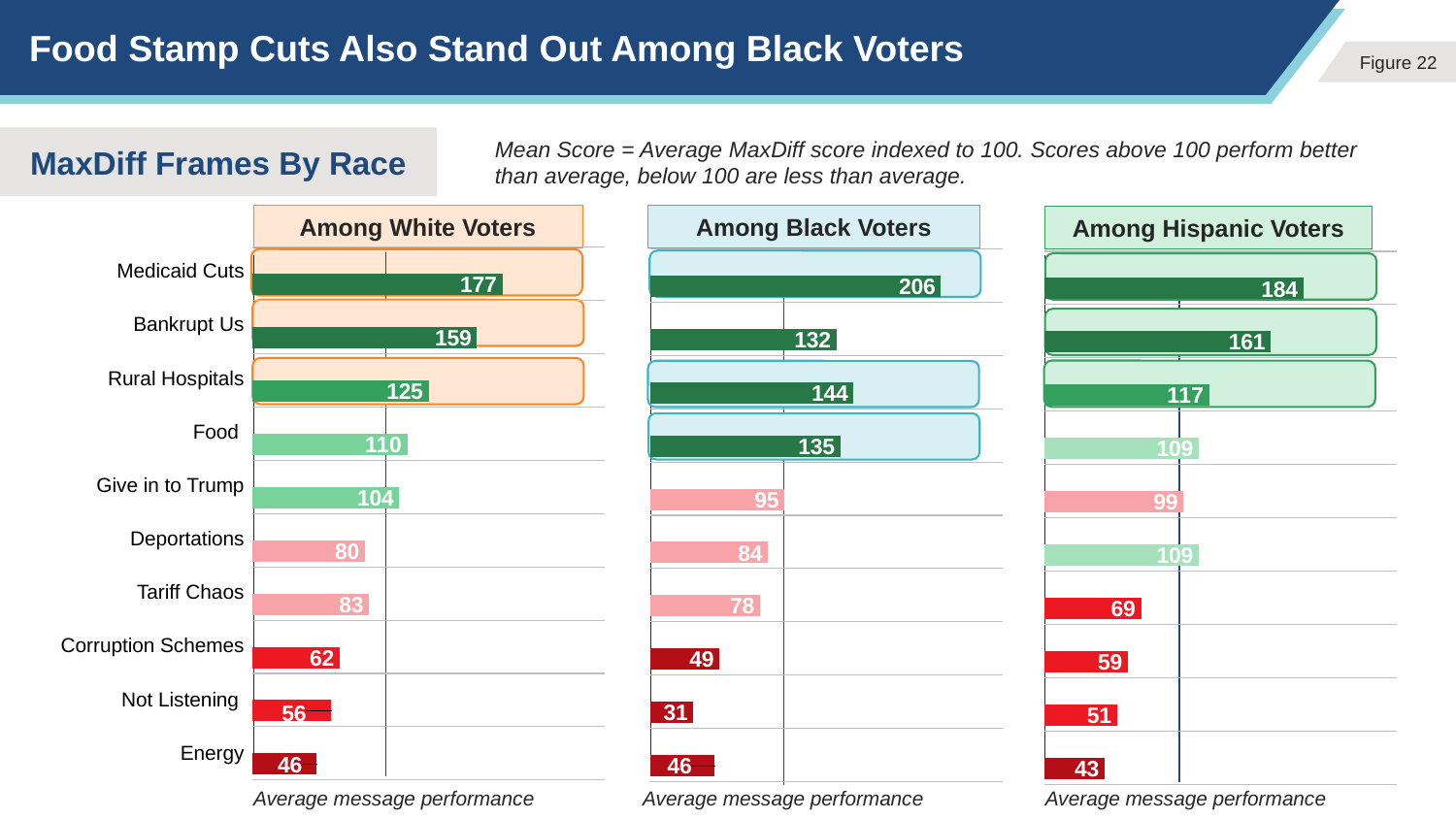
In the Among Hispanic Voters chart, what is the value for Rural Hospitals? 117 How many charts are shown on the slide? 3 In the Among White Voters chart, what is the difference between Medicaid Cuts and Energy? 131 In the Among Black Voters chart, which category has the lowest value? Not Listening In the Among Black Voters chart, what is the value for Food? 135 In the Among Black Voters chart, which is larger, Rural Hospitals or Food? Rural Hospitals In the Among White Voters chart, what is the value for Bankrupt Us? 159 What type of chart is the Among Black Voters chart? Bar chart How many categories are shown in the Among White Voters chart? 10 In the Among Hispanic Voters chart, which category has the highest value? Medicaid Cuts In the Among Black Voters chart, what is the value for Medicaid Cuts? 206 In the Among Hispanic Voters chart, what is the difference between Bankrupt Us and Corruption Schemes? 102